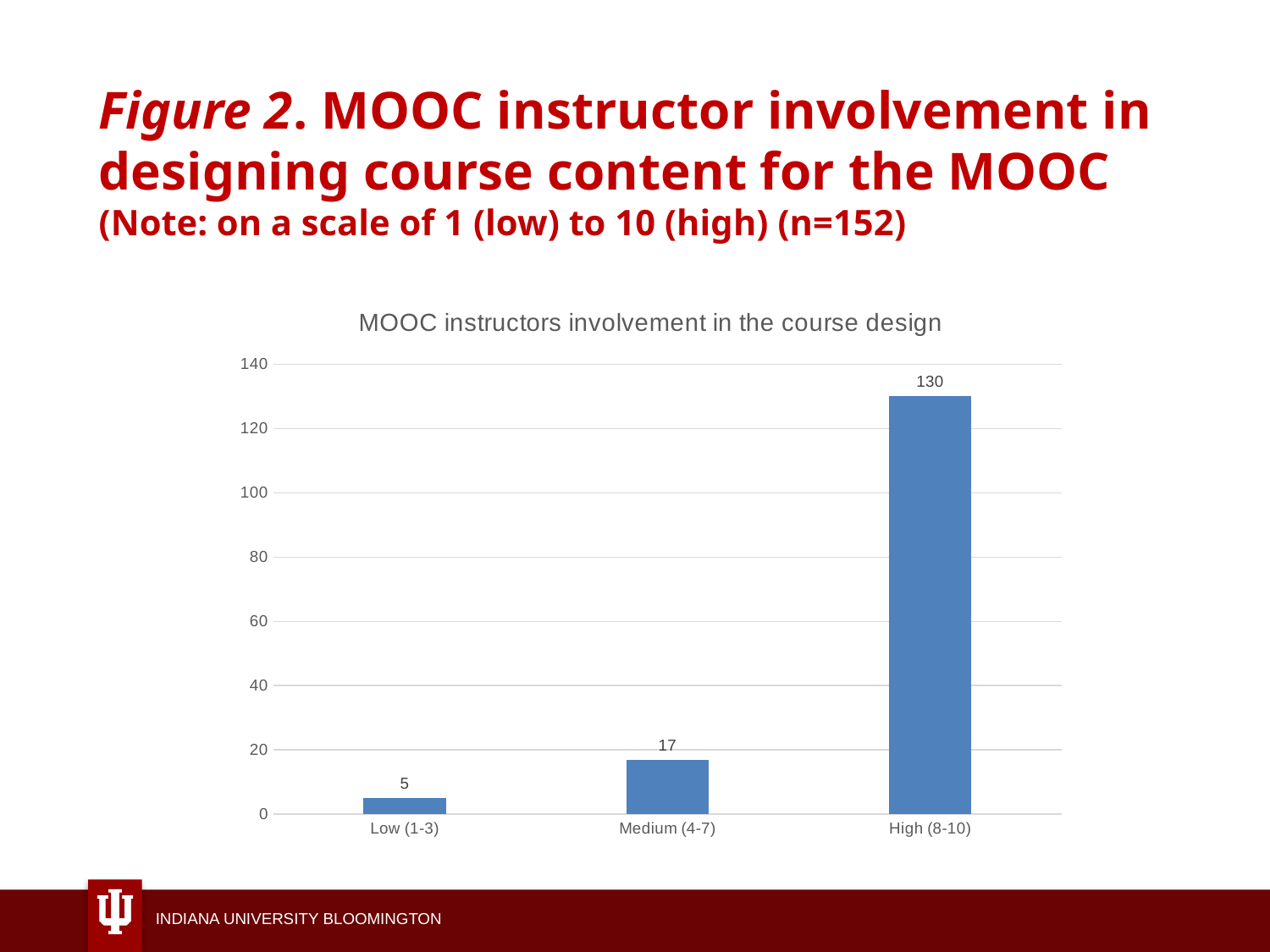
Which is larger, the value for Medium (4-7) or the value for Low (1-3)? Medium (4-7) How many categories are shown on the x axis? 3 Which category has the highest value? High (8-10) Which category has the lowest value? Low (1-3) What kind of chart is shown on the slide? bar chart Is the value for High (8-10) greater or less than 120? greater What is the difference between the values for High (8-10) and Medium (4-7)? 113 What is the difference between the values for Medium (4-7) and Low (1-3)? 12 What is the title of the chart? MOOC instructors involvement in the course design What is the value for Low (1-3)? 5 What is the value for High (8-10)? 130 What is the value for Medium (4-7)? 17